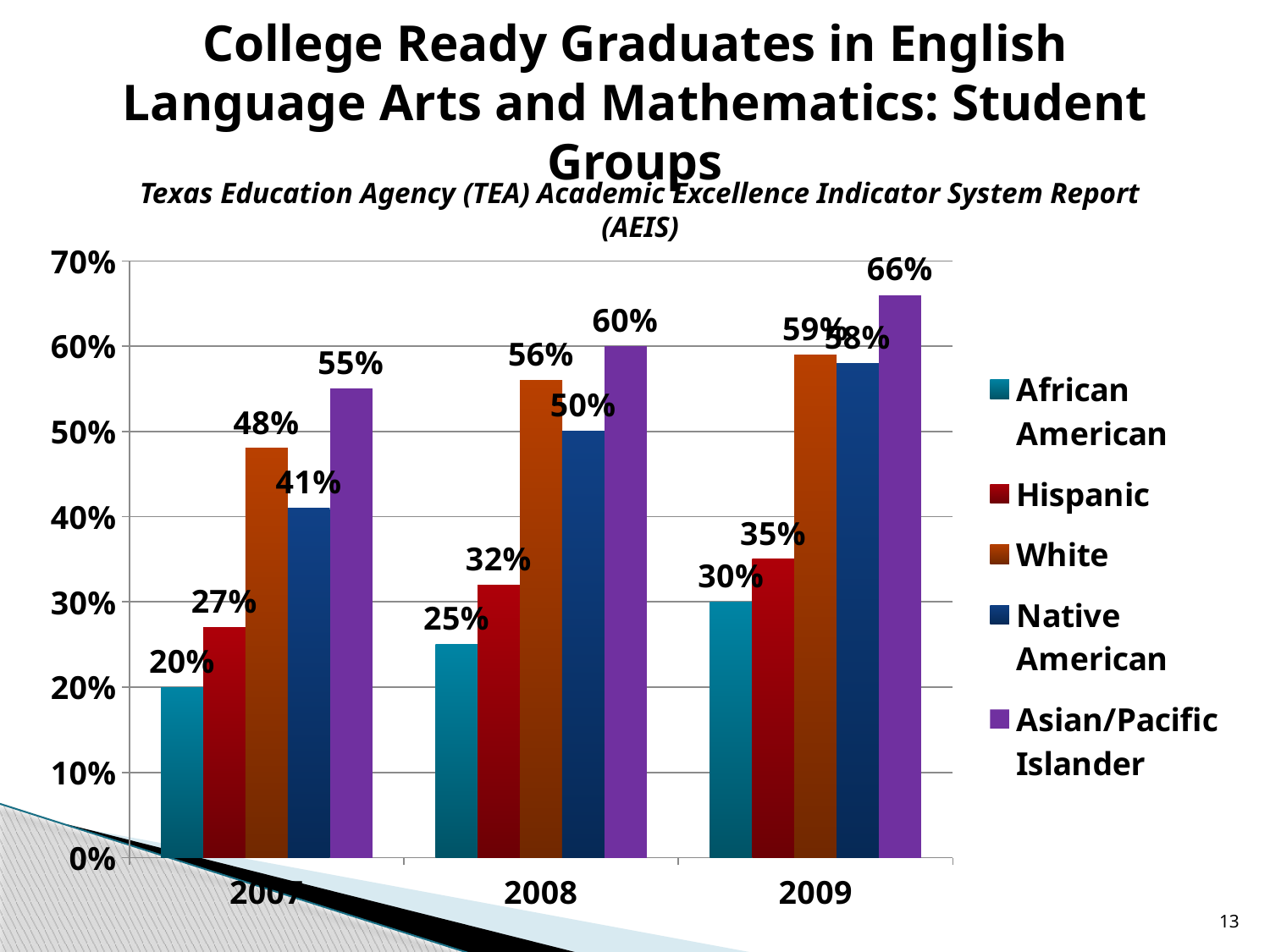
Does the African American value rise or fall from 2007 to 2009? rise How many years are shown on the x axis? 3 What is the value for Native American in 2007? 41% How many student groups does the legend list? 5 What is the difference between the Asian/Pacific Islander value and the African American value in 2007? 35% What is the value for African American in 2007? 20% Which is larger in 2008: the Hispanic value or the Native American value? Native American What is the value for Asian/Pacific Islander in 2009? 66% What is the value for White in 2008? 56% Which student group has the lowest value in 2009? African American Which student group has the highest value in 2008? Asian/Pacific Islander What kind of chart is shown on the slide? bar chart